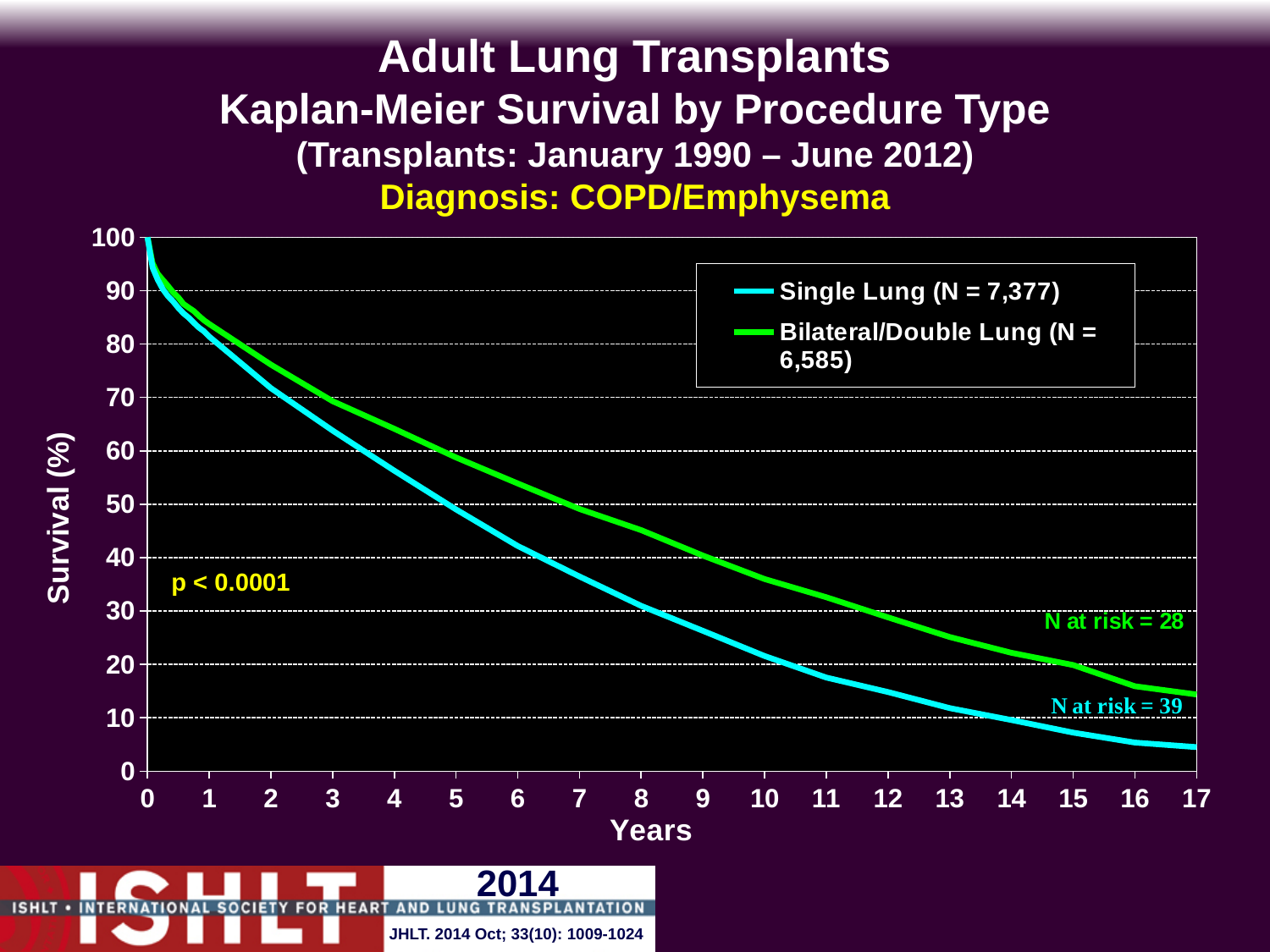
What is the N for the Bilateral/Double Lung group shown in the legend? 6,585 What is the N at risk shown for the Single Lung curve at the end of follow-up? 39 At 10 years, which curve shows higher survival, Single Lung or Bilateral/Double Lung? Bilateral/Double Lung What is the N at risk shown for the Bilateral/Double Lung curve at the end of follow-up? 28 What is the N for the Single Lung group shown in the legend? 7,377 Is the survival value for Bilateral/Double Lung at 10 years greater or less than 40? less Do the survival curves rise or fall as years increase? fall What kind of chart is shown on the slide? line chart What is the label of the y axis? Survival (%) What p-value is printed on the chart? p < 0.0001 Is the survival value for Single Lung at 17 years greater or less than 10? less How many series does the legend list? 2